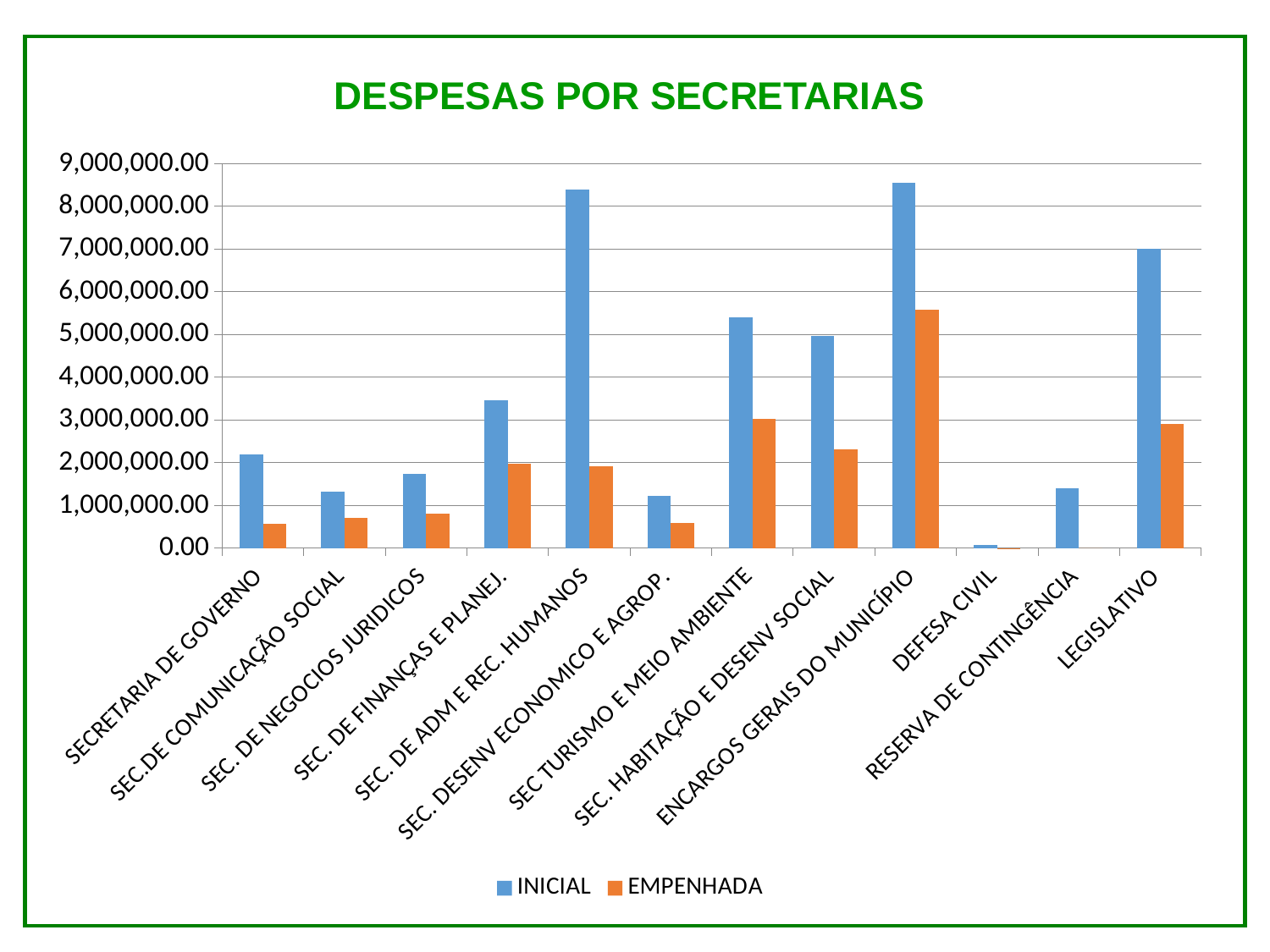
Which is larger, the INICIAL value for SEC.DE COMUNICAÇÃO SOCIAL or the INICIAL value for SEC. DE NEGOCIOS JURIDICOS? SEC. DE NEGOCIOS JURIDICOS Which category has the lowest INICIAL value? DEFESA CIVIL What is the title of the chart? DESPESAS POR SECRETARIAS Which is larger, the INICIAL value for SEC TURISMO E MEIO AMBIENTE or the INICIAL value for SEC. HABITAÇÃO E DESENV SOCIAL? SEC TURISMO E MEIO AMBIENTE Is the EMPENHADA value for LEGISLATIVO greater or less than 2,000,000.00? greater Which category has the highest EMPENHADA value? ENCARGOS GERAIS DO MUNICÍPIO How many series does the legend list? 2 Is the INICIAL value for SEC. DE ADM E REC. HUMANOS greater or less than 8,000,000.00? greater Is the INICIAL value for SEC TURISMO E MEIO AMBIENTE greater or less than 5,000,000.00? greater What kind of chart is shown on the slide? bar chart How many secretarias (categories) are shown on the x axis? 12